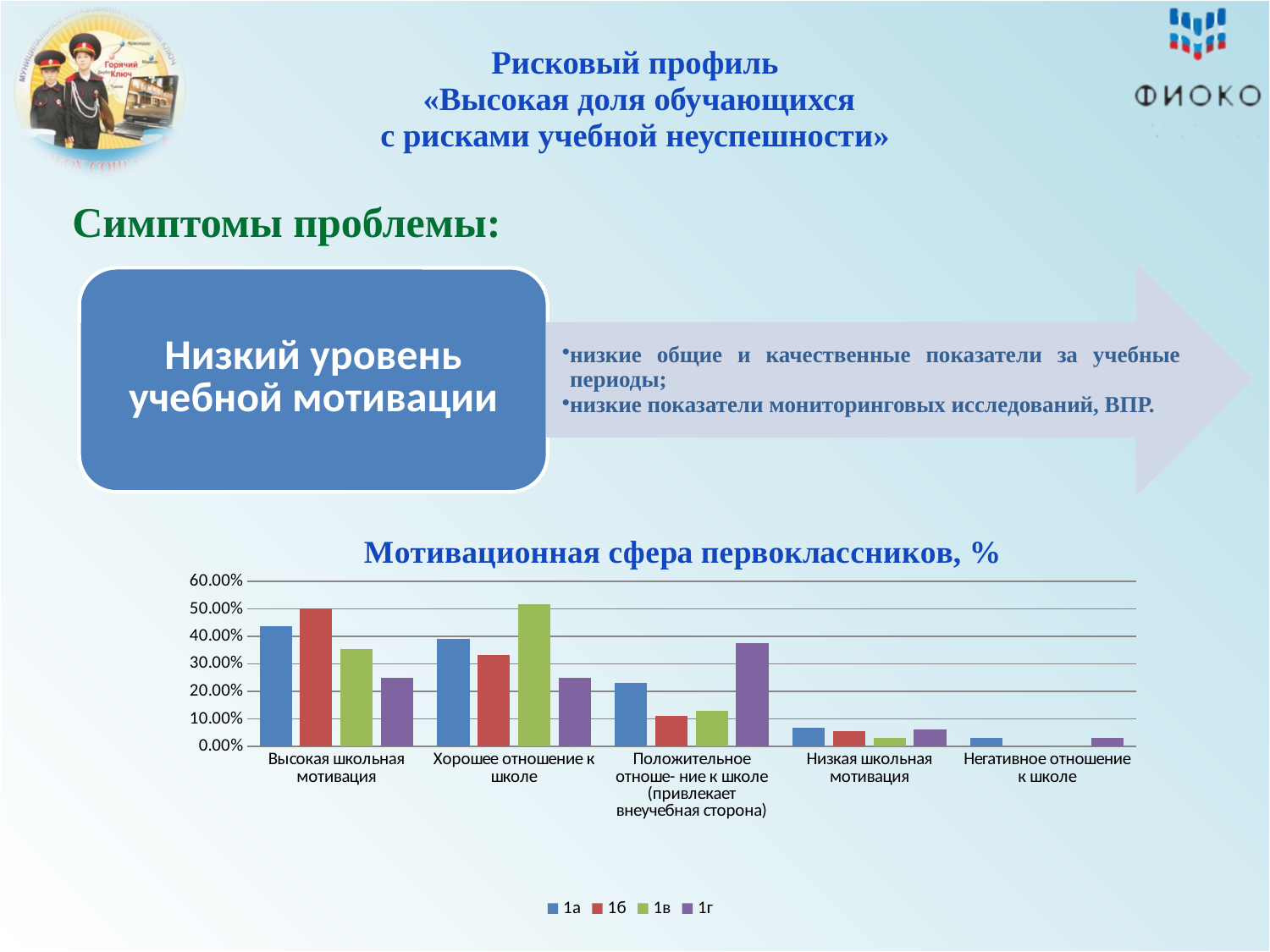
What kind of chart is shown under the heading «Мотивационная сфера первоклассников, %»? bar chart Which series are listed in the chart legend? 1а, 1б, 1в, 1г Is the value for 1б in the category «Положительное отношение к школе (привлекает внеучебная сторона)» greater or less than 20.00%? less How many categories are shown on the x axis of the chart «Мотивационная сфера первоклассников, %»? 5 In the category «Высокая школьная мотивация», which is larger: the value for 1а or the value for 1г? 1а Which series has the highest value in the category «Положительное отношение к школе (привлекает внеучебная сторона)»? 1г Is the value for 1в in the category «Хорошее отношение к школе» greater or less than 40.00%? greater Is the value for 1г in the category «Положительное отношение к школе (привлекает внеучебная сторона)» greater or less than 30.00%? greater Which series has the highest value in the category «Высокая школьная мотивация»? 1б Which series has the highest value in the category «Хорошее отношение к школе»? 1в How many series does the legend of the chart list? 4